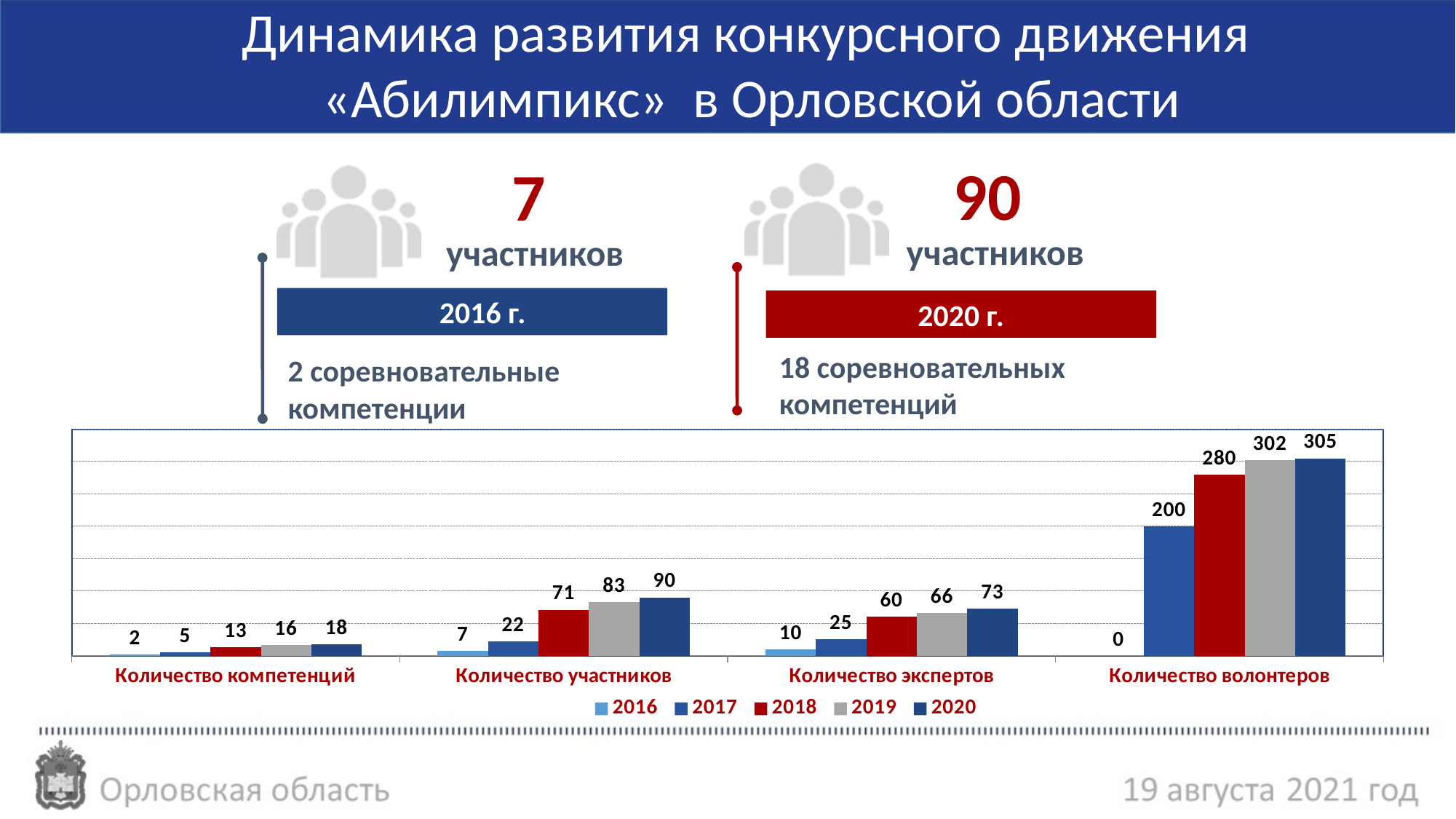
What kind of chart is shown on the slide? Bar chart Which year has the lowest value in the category «Количество участников»? 2016 How many categories are shown on the x axis of the chart? 4 Which year has the highest value in the category «Количество волонтеров»? 2020 What is the value for 2020 in the category «Количество участников»? 90 Do the values for «Количество экспертов» rise or fall from 2016 to 2020? Rise What is the value for 2018 in the category «Количество волонтеров»? 280 Which is larger: the 2019 value for «Количество экспертов» or the 2019 value for «Количество участников»? Количество участников What is the value for 2016 in the category «Количество экспертов»? 10 What is the value for 2019 in the category «Количество компетенций»? 16 How many series does the chart legend list? 5 What is the difference between the 2020 and 2016 values in the category «Количество участников»? 83